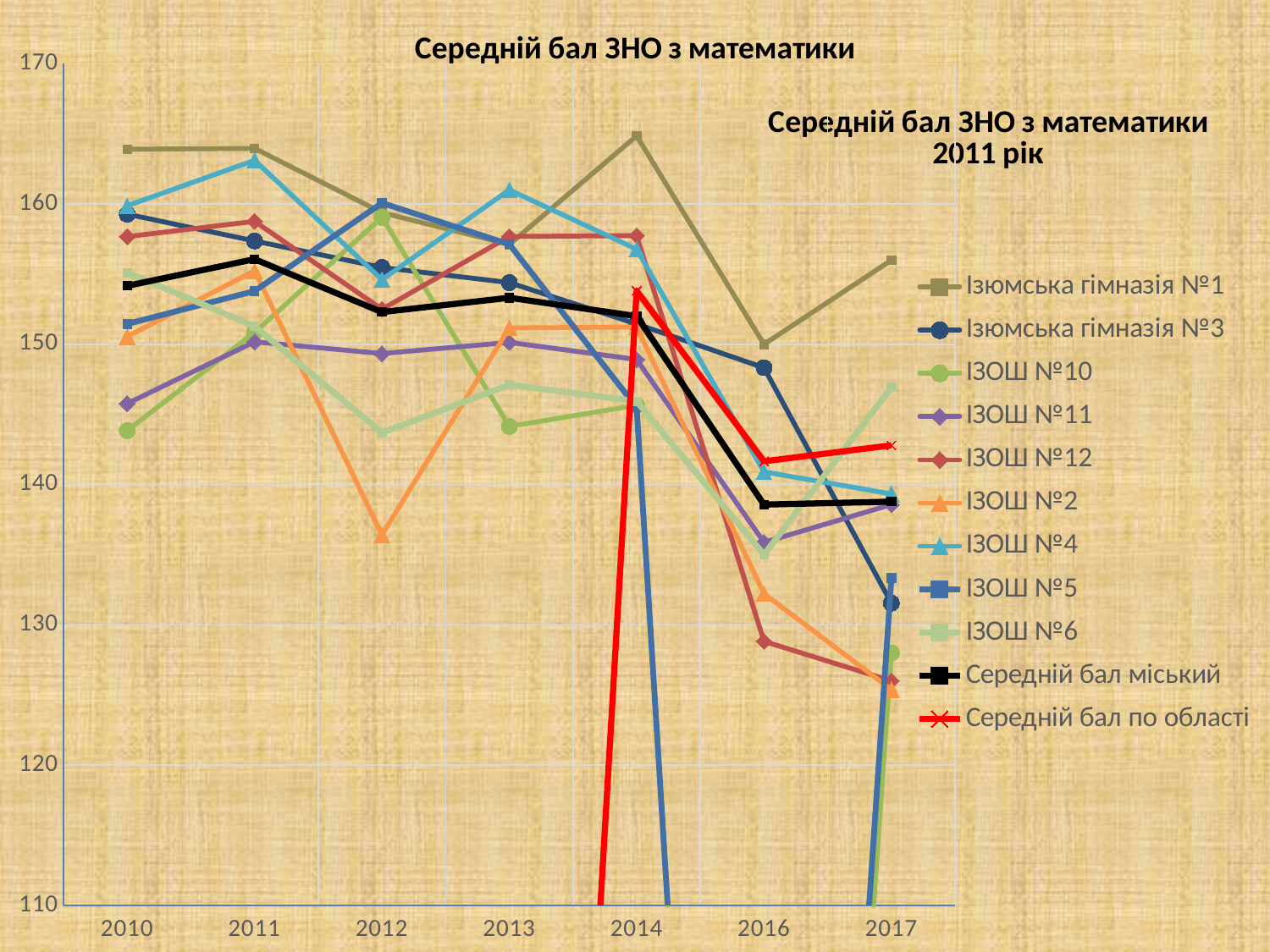
Which series has the highest value in 2010? Ізюмська гімназія №1 Which series has the highest value in 2014? Ізюмська гімназія №1 Does the Середній бал міський line rise or fall overall from 2010 to 2017? Falls Which series has the highest value in 2013? ІЗОШ №4 Is the value for Середній бал міський in 2017 greater or less than 140? less What kind of chart is shown on the slide? Line chart Is the value for ІЗОШ №2 in 2012 greater or less than 140? less Is the value for Ізюмська гімназія №1 in 2014 greater or less than 160? greater How many years are shown on the x axis? 7 In 2016, which is larger: the value for Ізюмська гімназія №1 or the value for ІЗОШ №12? Ізюмська гімназія №1 How many series does the legend list? 11